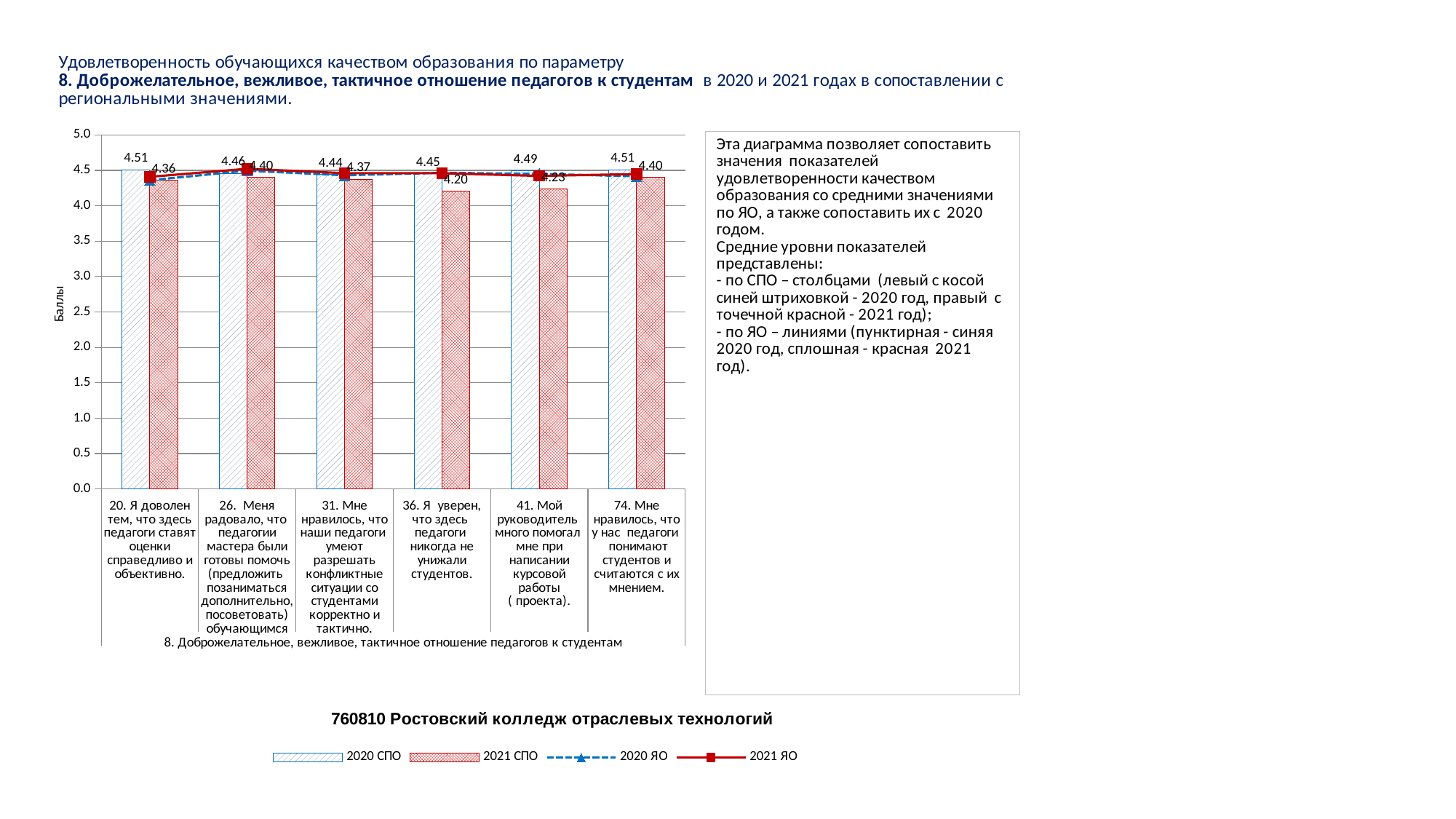
What is the value of the 2021 СПО bar for item 74 ("Мне нравилось, что у нас педагоги понимают студентов и считаются с их мнением")? 4.40 Which item has the lowest 2021 СПО value? 36. Я уверен, что здесь педагоги никогда не унижали студентов. What is the title of the vertical axis of the chart? Баллы What is the value of the 2020 СПО bar for item 20 ("Я доволен тем, что здесь педагоги ставят оценки справедливо и объективно")? 4.51 What is the value of the 2020 СПО bar for item 41 ("Мой руководитель много помогал мне при написании курсовой работы")? 4.49 How many items (categories) are shown on the x axis of the chart? 6 For item 41, which is larger: the 2020 СПО value or the 2021 СПО value? 2020 СПО What is the difference between the 2020 СПО and 2021 СПО values for item 20? 0.15 How many series does the chart legend list? 4 What is the value of the 2021 СПО bar for item 36 ("Я уверен, что здесь педагоги никогда не унижали студентов")? 4.20 What is the difference between the 2020 СПО and 2021 СПО values for item 36? 0.25 Is the 2021 СПО value for item 36 greater or less than 4.0? greater